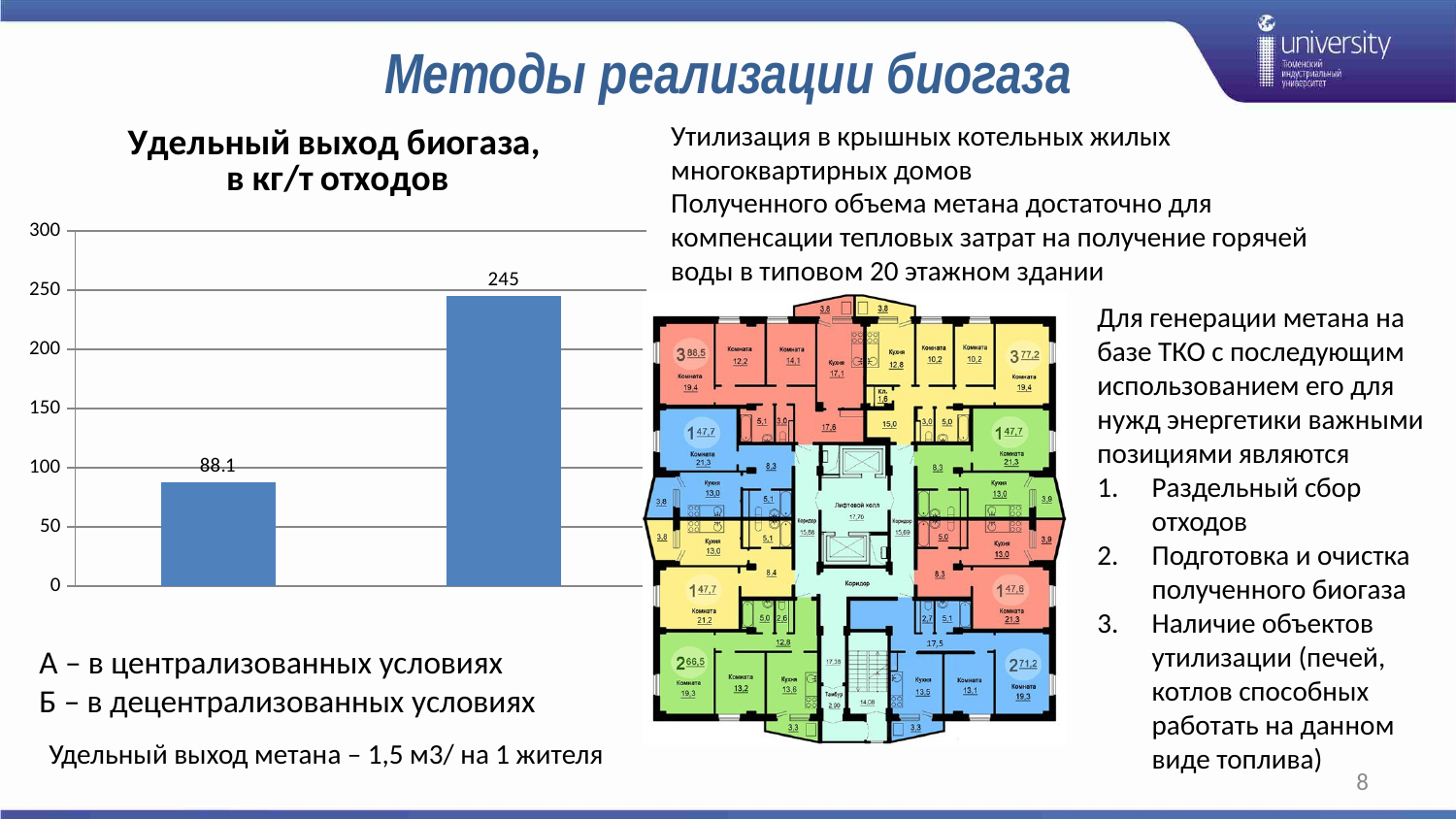
Is the value of the left bar greater or less than 100? less Which bar has the higher value, the left or the right one? the right bar Which bar has the lower value, the left or the right one? the left bar How many bars are plotted in the chart? 2 Is the value of the right bar greater or less than 200? greater What is the value shown on the right bar of the chart? 245 What type of chart is shown on the slide? bar chart What is the difference between the values of the right bar and the left bar? 156.9 What is the title of the chart? Удельный выход биогаза, в кг/т отходов Do the bar values rise or fall from left to right? rise Is the value of the left bar larger or smaller than the value of the right bar? smaller What is the value shown on the left bar of the chart? 88.1